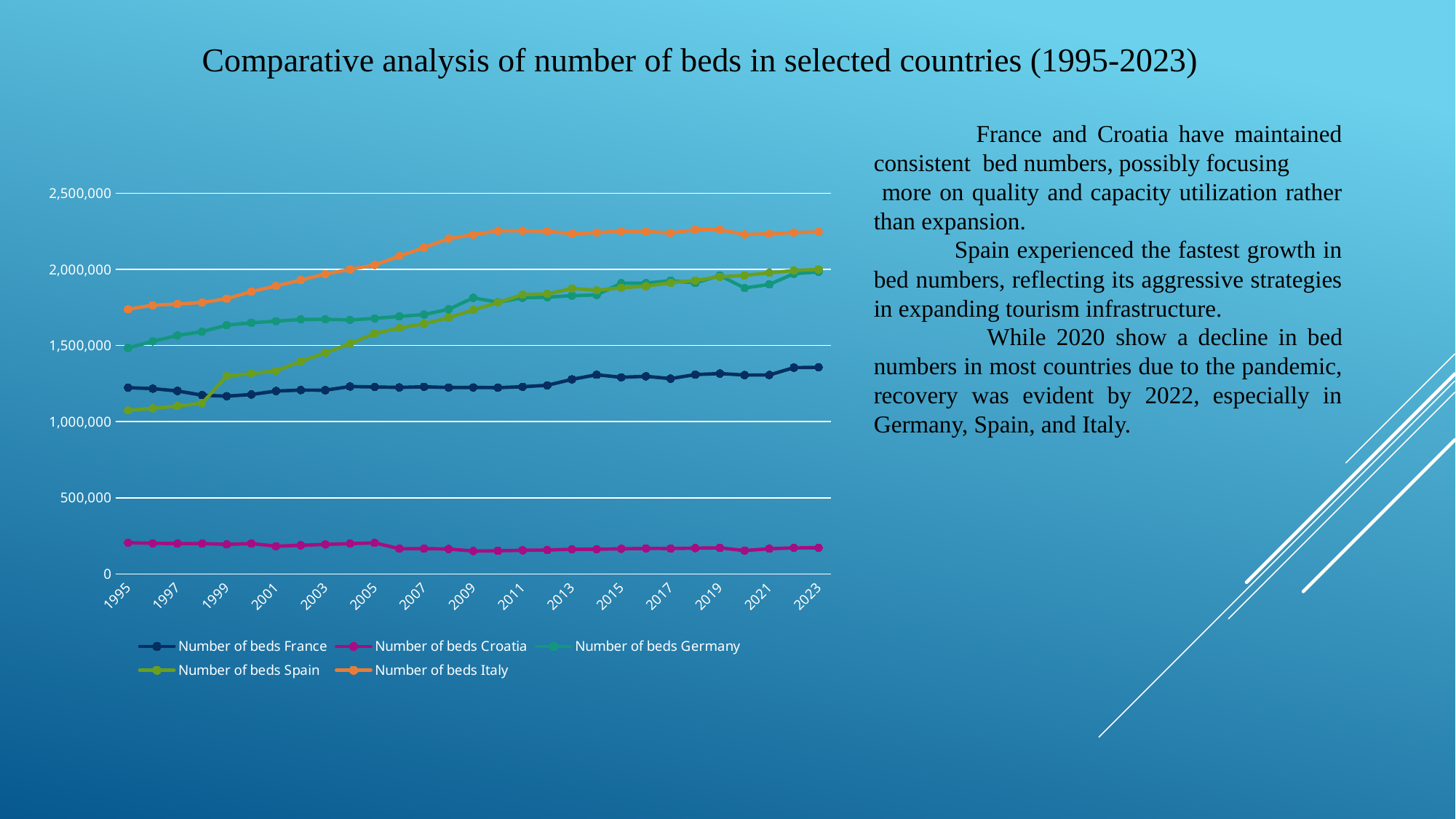
What kind of chart is shown on the slide? Line chart Which is larger in 1995, the number of beds in Germany or in Spain? Germany How many series does the legend list? 5 Is the number of beds in Italy in 2023 greater or less than 2,000,000? greater Is the number of beds in Italy in 1995 greater or less than 2,000,000? less Is the number of beds in France in 1995 greater or less than 1,000,000? greater Which is larger in 2011, the number of beds in Italy or in France? Italy Does the number of beds in Spain generally rise or fall from 1995 to 2023? Rise Which country has the highest number of beds in 2023? Italy Which country has the lowest number of beds throughout the period? Croatia What is the title of the slide's chart analysis? Comparative analysis of number of beds in selected countries (1995-2023)